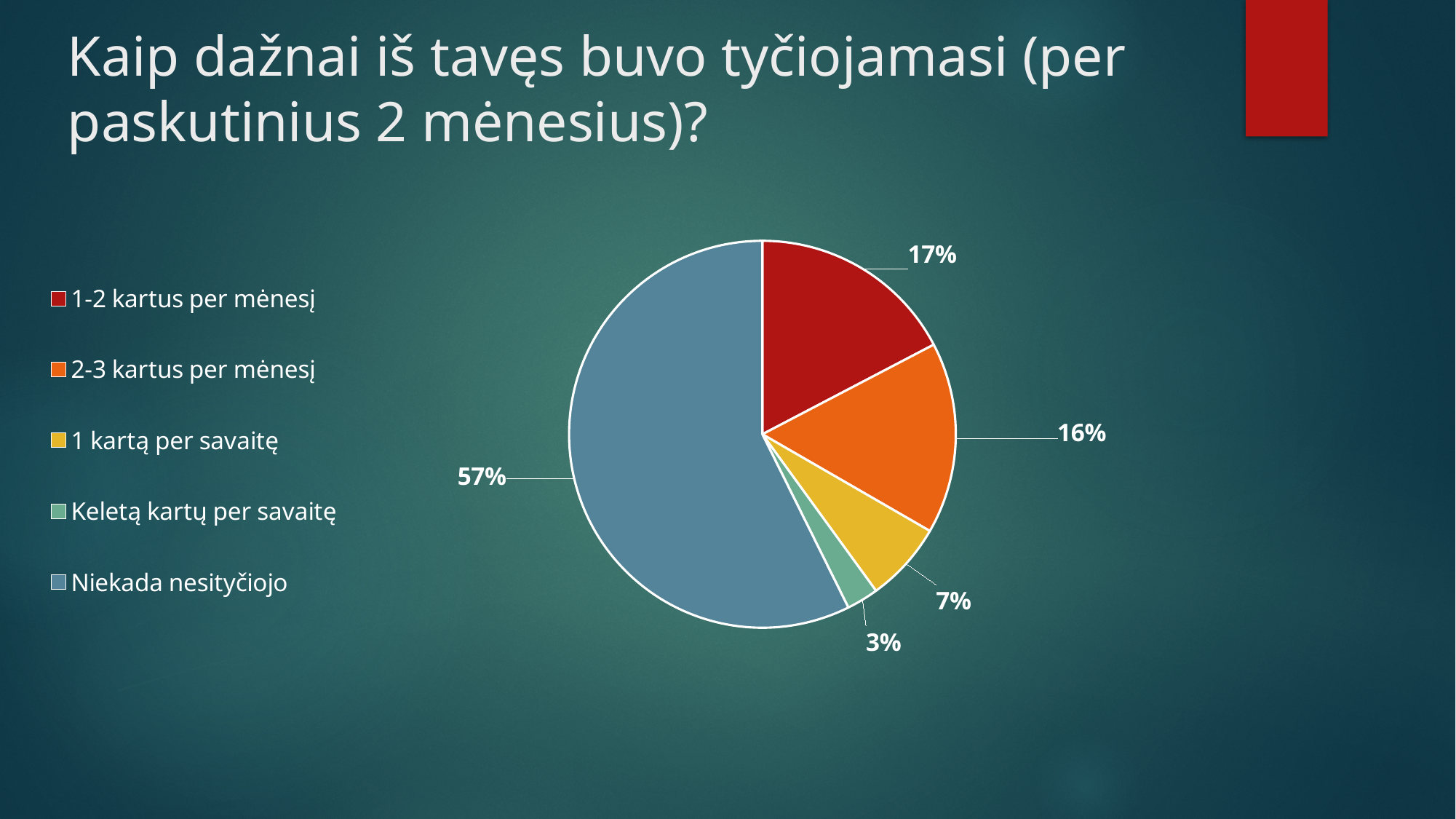
What is the value for "1-2 kartus per mėnesį"? 17% How many categories does the pie chart have? 5 Which category has the largest slice? Niekada nesityčiojo What is the value for "1 kartą per savaitę"? 7% Which is larger, the value for "1 kartą per savaitę" or "Keletą kartų per savaitę"? 1 kartą per savaitę What is the difference between the values for "Niekada nesityčiojo" and "1-2 kartus per mėnesį"? 40% What is the value for "Keletą kartų per savaitę"? 3% What colour is the slice for "Niekada nesityčiojo"? blue-grey What is the value for "2-3 kartus per mėnesį"? 16% Which category has the smallest slice? Keletą kartų per savaitę What share of the pie does "Niekada nesityčiojo" have? 57% What kind of chart is shown on the slide? pie chart